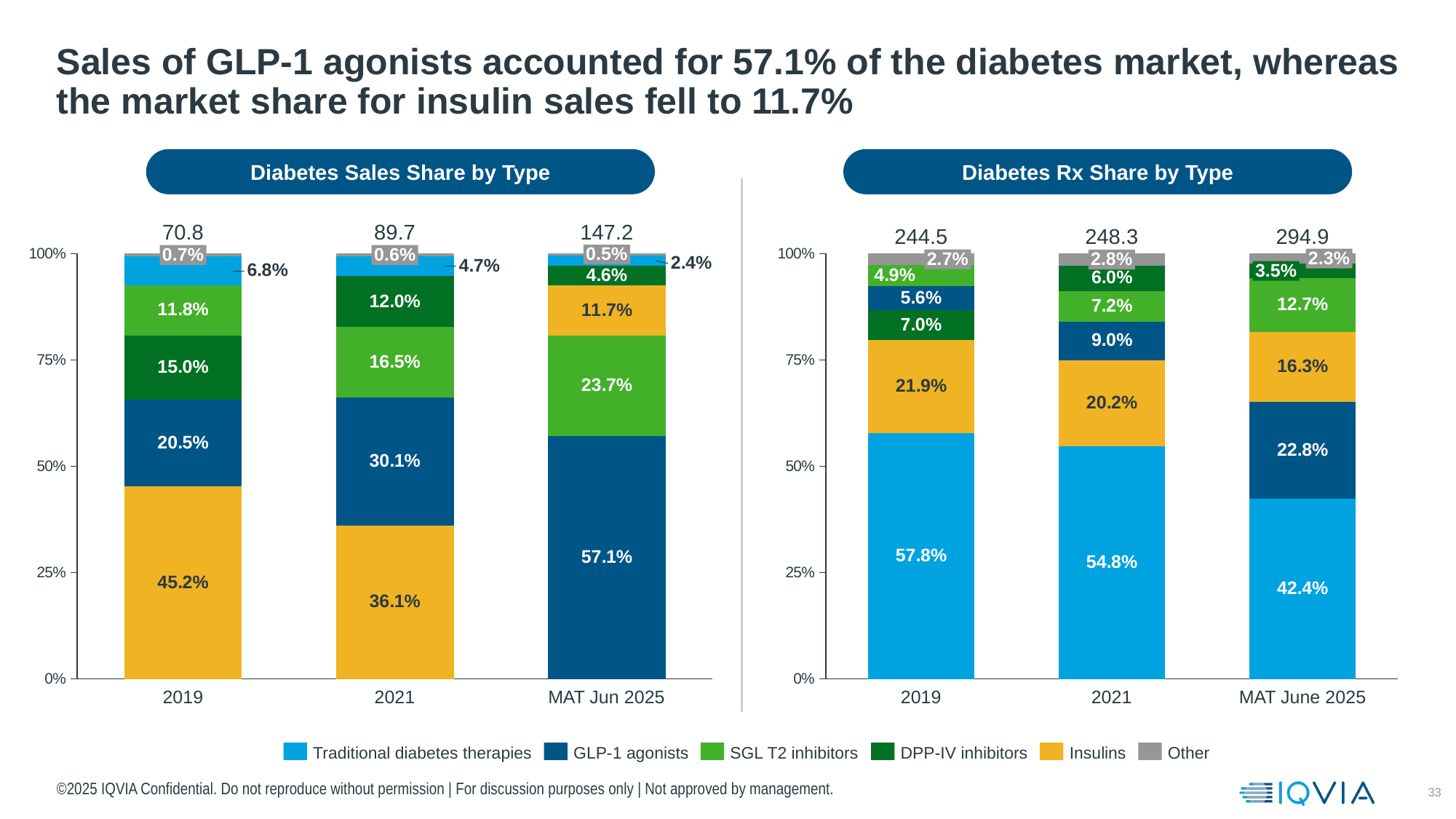
In the Diabetes Rx Share by Type chart, what total value is printed above the MAT June 2025 bar? 294.9 In the Diabetes Rx Share by Type chart, what is the share for Traditional diabetes therapies in 2021? 54.8% How many series does the legend list? 6 In the Diabetes Rx Share by Type chart, which type has the smallest share in 2021? Other In the Diabetes Rx Share by Type chart, does the share for Traditional diabetes therapies rise or fall from 2019 to MAT June 2025? fall In the Diabetes Sales Share by Type chart, what is the share for Insulins in 2019? 45.2% In the Diabetes Sales Share by Type chart, what is the difference between the Insulins share in 2019 and in MAT Jun 2025? 33.5% In the Diabetes Rx Share by Type chart, is the GLP-1 agonists share larger in 2019 or in MAT June 2025? MAT June 2025 In the Diabetes Sales Share by Type chart, which type has the largest share in 2019? Insulins In the Diabetes Rx Share by Type chart, what is the share for SGL T2 inhibitors in MAT June 2025? 12.7% In the Diabetes Sales Share by Type chart, what is the share for GLP-1 agonists in MAT Jun 2025? 57.1% In the Diabetes Sales Share by Type chart, what total value is printed above the 2021 bar? 89.7